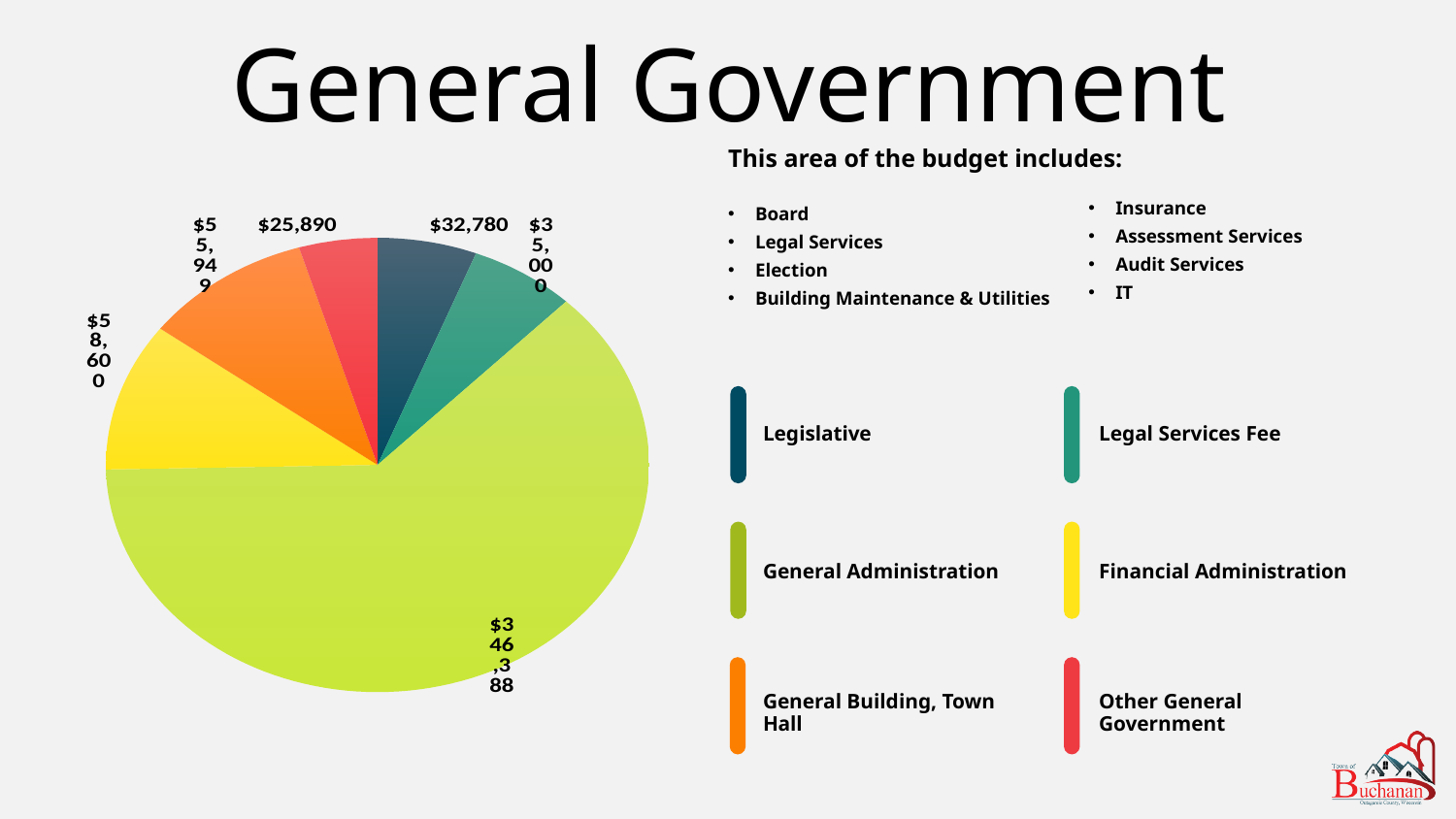
What is the difference between the Legislative value and the Other General Government value? $6,890 What type of chart is shown on the slide? pie chart What is the value shown for Other General Government in the pie chart? $25,890 How many slices does the pie chart have? 6 What colour is the General Building, Town Hall slice in the pie chart? orange Which category has the largest slice in the pie chart? General Administration Which is larger, the value for Legislative or the value for Other General Government? Legislative Which category has the smallest slice in the pie chart? Other General Government How many entries does the legend of the pie chart list? 6 What is the value shown for General Administration in the pie chart? $346,388 What is the value shown for Legislative in the pie chart? $32,780 What is the value shown for Financial Administration in the pie chart? $58,600